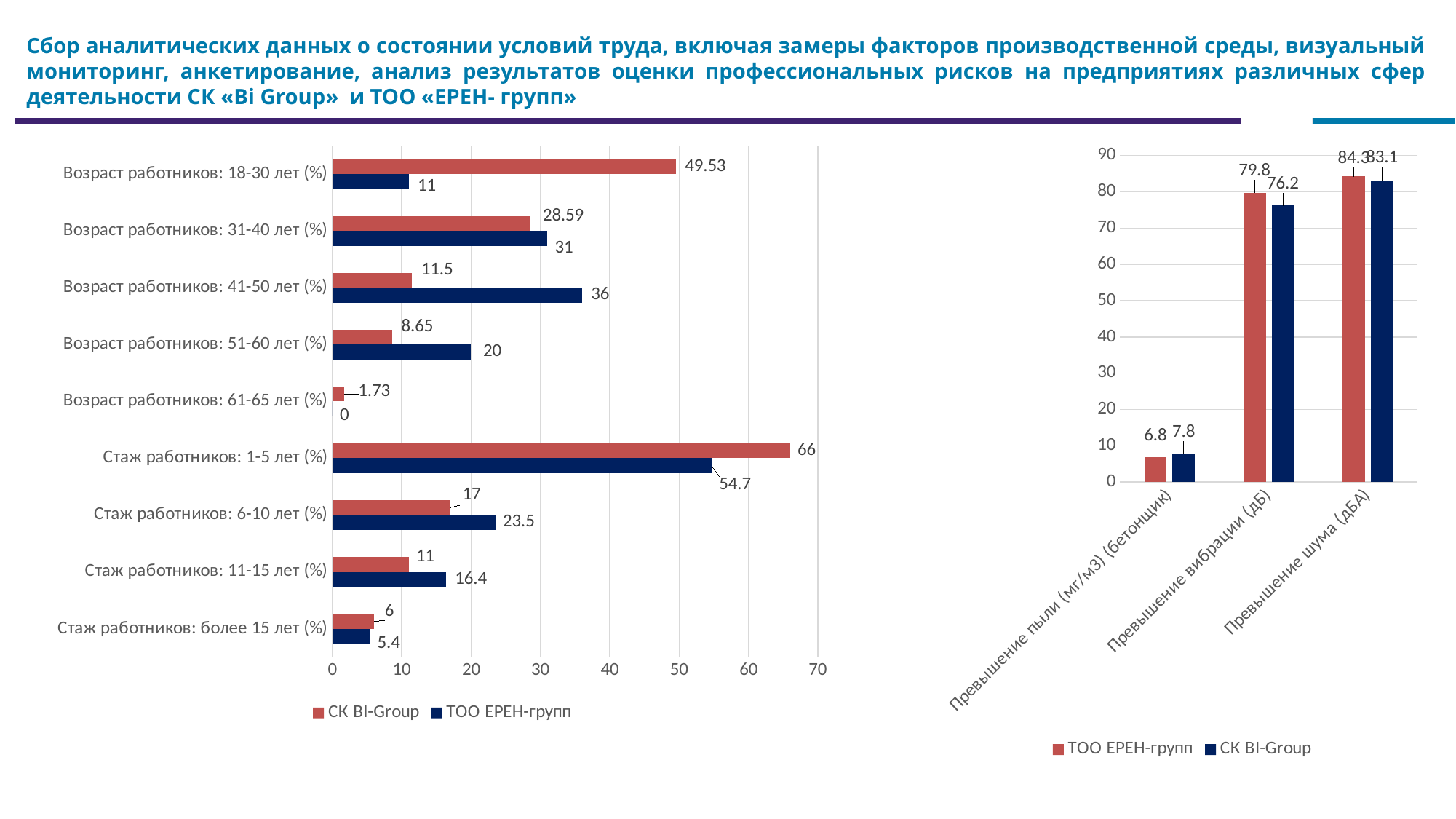
What type of chart is the left chart? Bar chart In the left chart, which category has the highest value for СК BI-Group? Стаж работников: 1-5 лет (%) In the left chart, what is the value for ТОО ЕРЕН-групп in the category 'Возраст работников: 41-50 лет (%)'? 36 In the left chart, what is the difference between the ТОО ЕРЕН-групп and СК BI-Group values for 'Возраст работников: 51-60 лет (%)'? 11.35 In the right chart, what is the difference between the СК BI-Group and ТОО ЕРЕН-групп values for 'Превышение пыли (мг/м3) (бетонщик)'? 1 How many categories are shown in the left chart? 9 In the right chart, what is the value for ТОО ЕРЕН-групп for 'Превышение вибрации (дБ)'? 79.8 In the left chart, what is the value for СК BI-Group in the category 'Возраст работников: 18-30 лет (%)'? 49.53 In the left chart, which series has the larger value for 'Стаж работников: 6-10 лет (%)'? ТОО ЕРЕН-групп In the left chart, what is the value for ТОО ЕРЕН-групп in the category 'Стаж работников: 1-5 лет (%)'? 54.7 How many series does the legend of the right chart list? 2 In the left chart, which category has the lowest value for ТОО ЕРЕН-групп? Возраст работников: 61-65 лет (%)